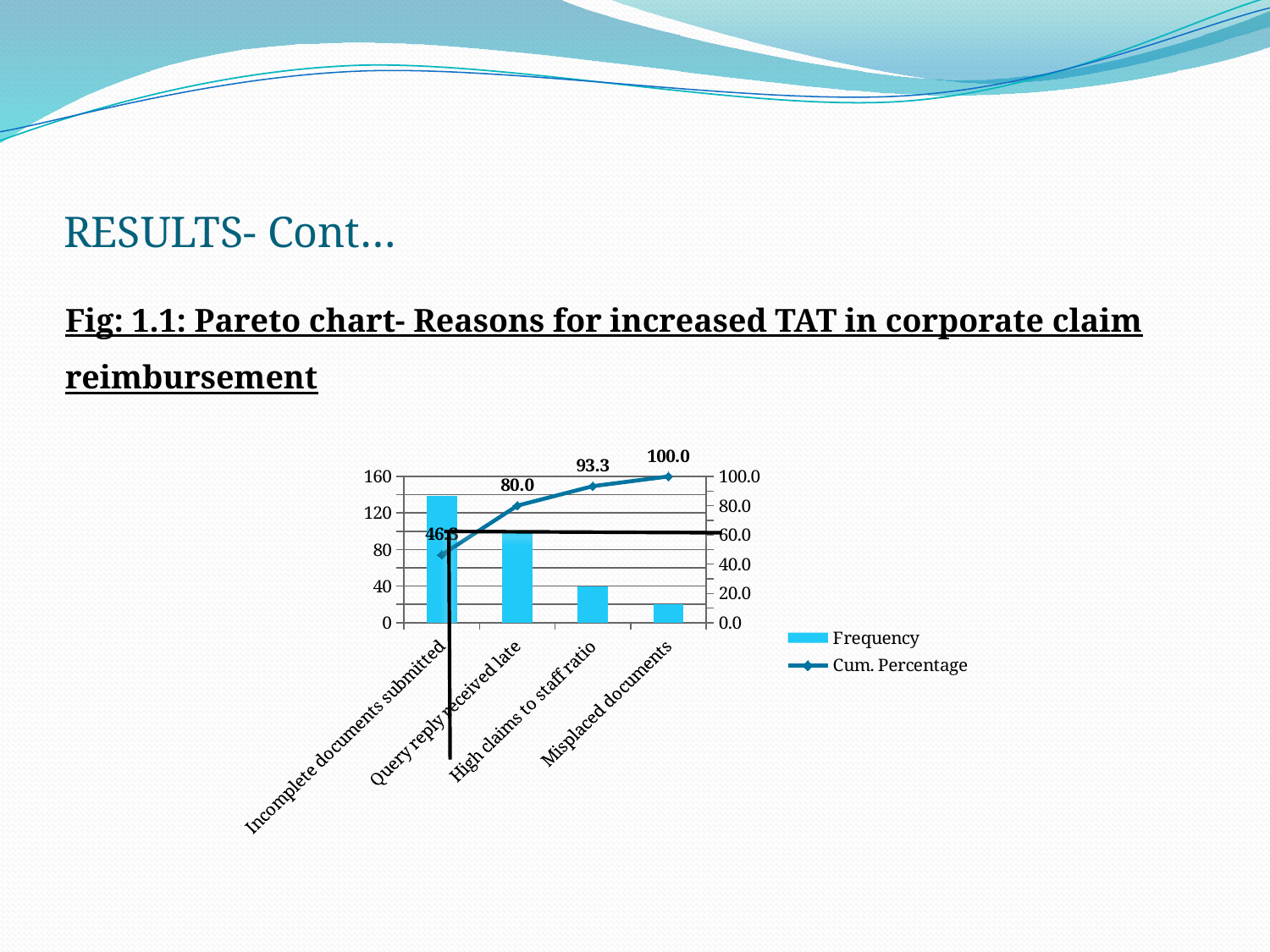
What is the Cum. Percentage value for High claims to staff ratio? 93.3 Which category has the highest Frequency? Incomplete documents submitted How many series does the legend list? 2 What is the Cum. Percentage value for Misplaced documents? 100.0 Which has the larger Frequency, Query reply received late or High claims to staff ratio? Query reply received late Which category has the lowest Frequency? Misplaced documents Is the Frequency for Incomplete documents submitted greater or less than 120? greater Is the Frequency for Misplaced documents greater or less than 40? less What is the difference in Cum. Percentage between High claims to staff ratio and Query reply received late? 13.3 What is the difference in Cum. Percentage between Misplaced documents and High claims to staff ratio? 6.7 What is the Cum. Percentage value for Query reply received late? 80.0 How many categories are shown on the x axis? 4